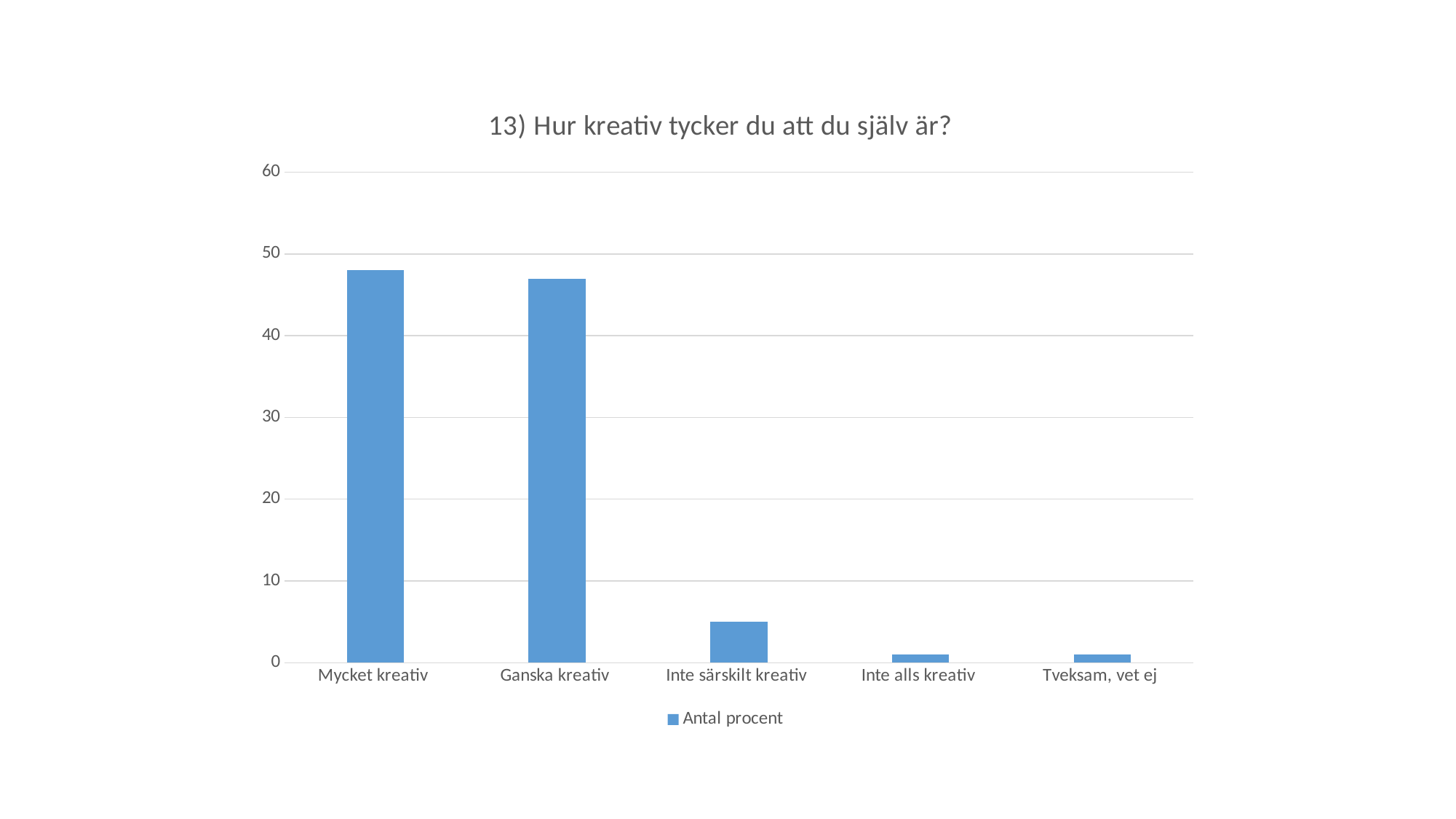
How many series does the legend list? 1 Which is larger, the value for Mycket kreativ or the value for Inte särskilt kreativ? Mycket kreativ Is the value for Ganska kreativ greater or less than 50? less How many categories are shown on the x axis of the chart? 5 What is the name of the series shown in the legend? Antal procent What is the title of the chart? 13) Hur kreativ tycker du att du själv är? Is the value for Inte särskilt kreativ greater or less than 10? less Is the value for Mycket kreativ greater or less than 40? greater Which is larger, the value for Ganska kreativ or the value for Tveksam, vet ej? Ganska kreativ Do the values generally rise or fall moving from left to right along the x axis? fall What kind of chart is shown on the slide? bar chart